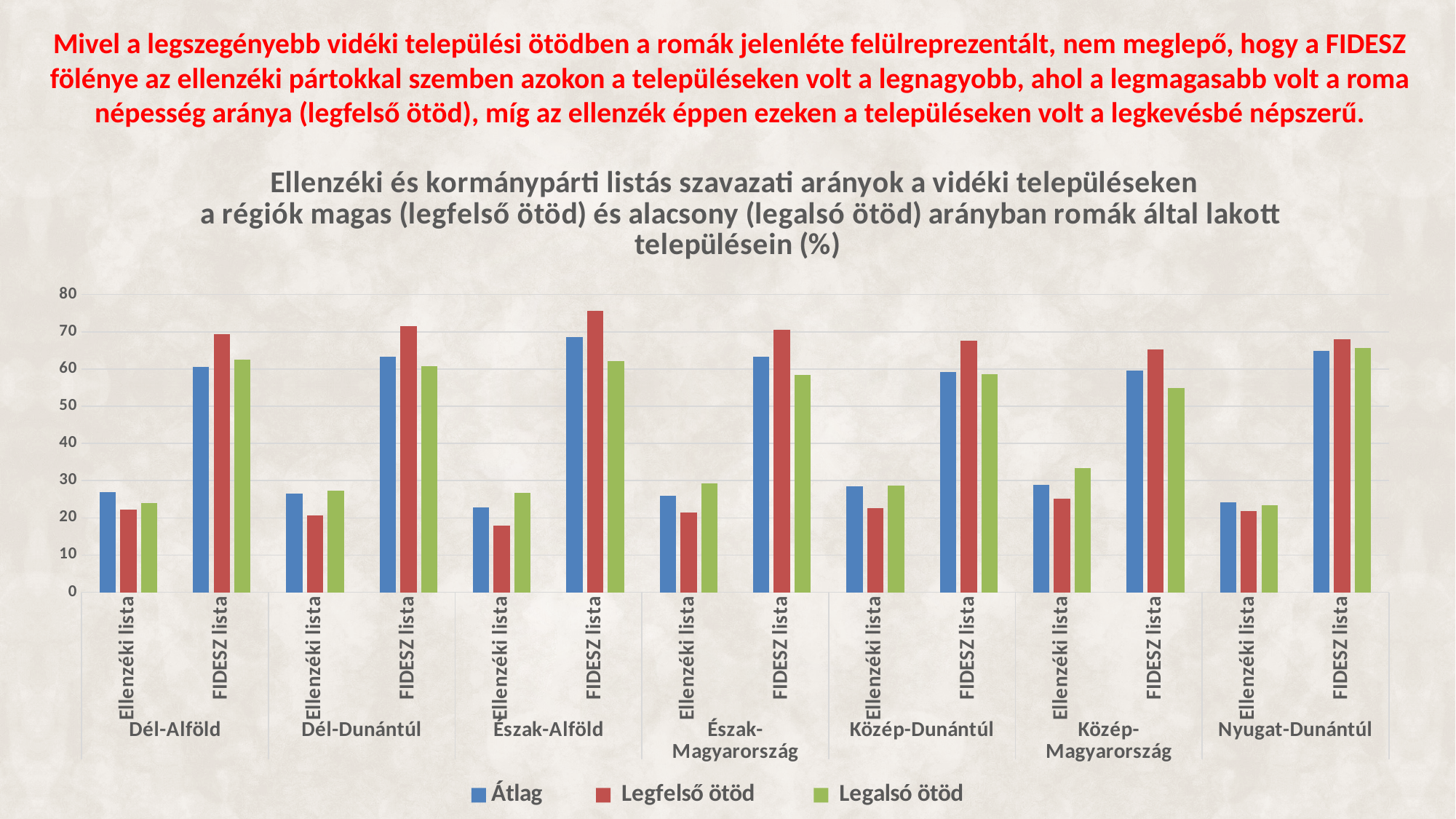
Which series is shown in red in the legend? Legfelső ötöd In which region does the FIDESZ lista Legfelső ötöd bar reach its highest value? Észak-Alföld In which region is the Ellenzéki lista Legfelső ötöd bar the lowest? Észak-Alföld How many series does the legend list? 3 Is the Legfelső ötöd value for FIDESZ lista in Észak-Alföld greater or less than 70? greater For Ellenzéki lista in Közép-Magyarország, which is larger: the Legfelső ötöd value or the Legalsó ötöd value? Legalsó ötöd Is the Legfelső ötöd value for Ellenzéki lista in Észak-Alföld greater or less than 20? less Is the Legalsó ötöd value for Ellenzéki lista in Közép-Magyarország greater or less than 30? greater For FIDESZ lista in Dél-Dunántúl, which is larger: the Legfelső ötöd value or the Legalsó ötöd value? Legfelső ötöd How many regions are shown along the x axis? 7 What kind of chart is shown on the slide? bar chart